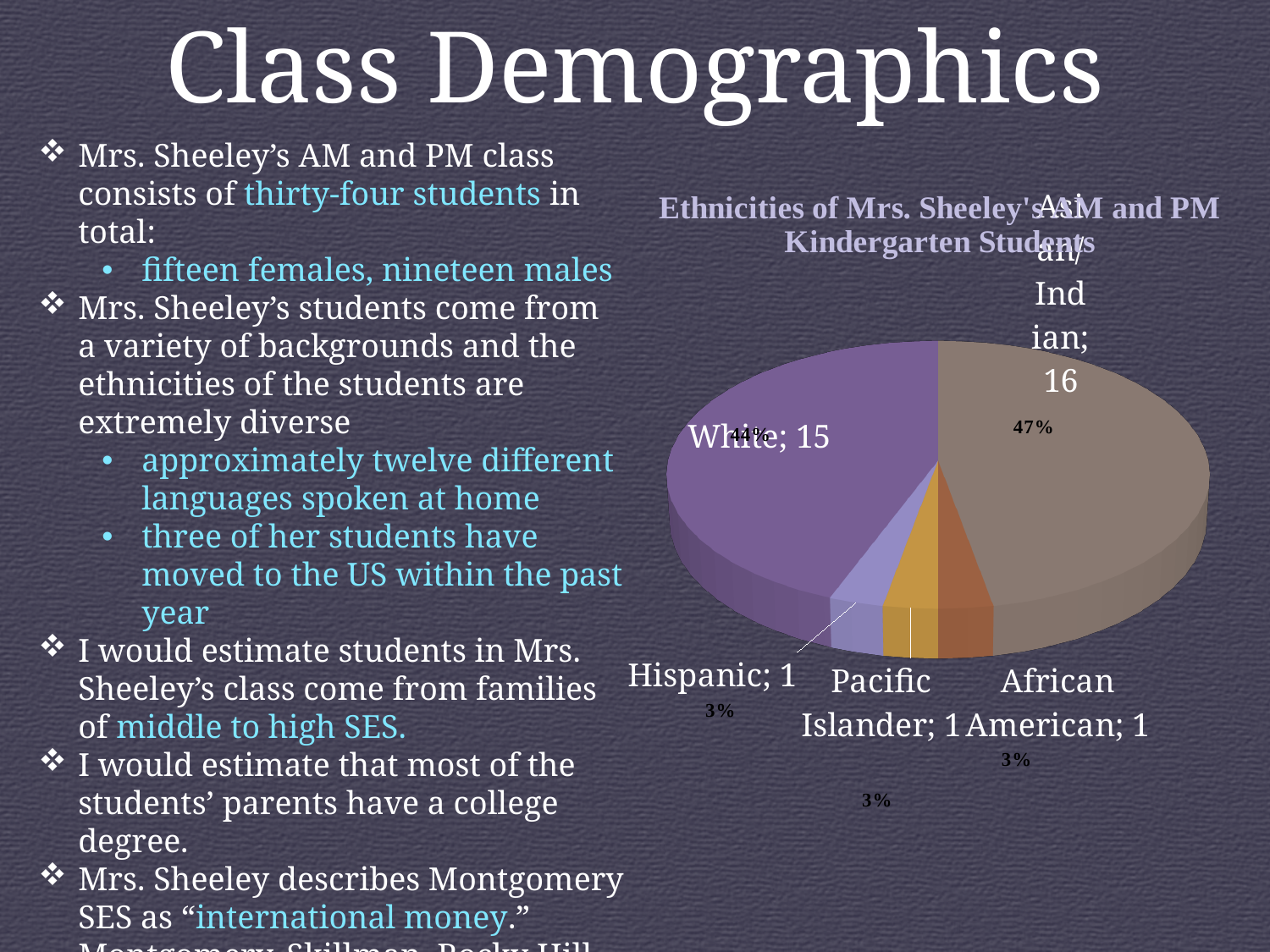
How many students are in the Asian/Indian slice of the pie chart? 16 What percentage share does the White slice have? 44% Which slice is larger, Pacific Islander or White? White What percentage share does the African American slice have? 3% How many slices does the pie chart have? 5 What is the title of the chart? Ethnicities of Mrs. Sheeley's AM and PM Kindergarten Students Which ethnicity has the largest slice of the pie chart? Asian/Indian What percentage share does the Asian/Indian slice have? 47% How many students are in the Hispanic slice of the pie chart? 1 What kind of chart is shown on the slide? pie chart How many students are in the White slice of the pie chart? 15 What is the difference in student count between the Asian/Indian and White slices? 1